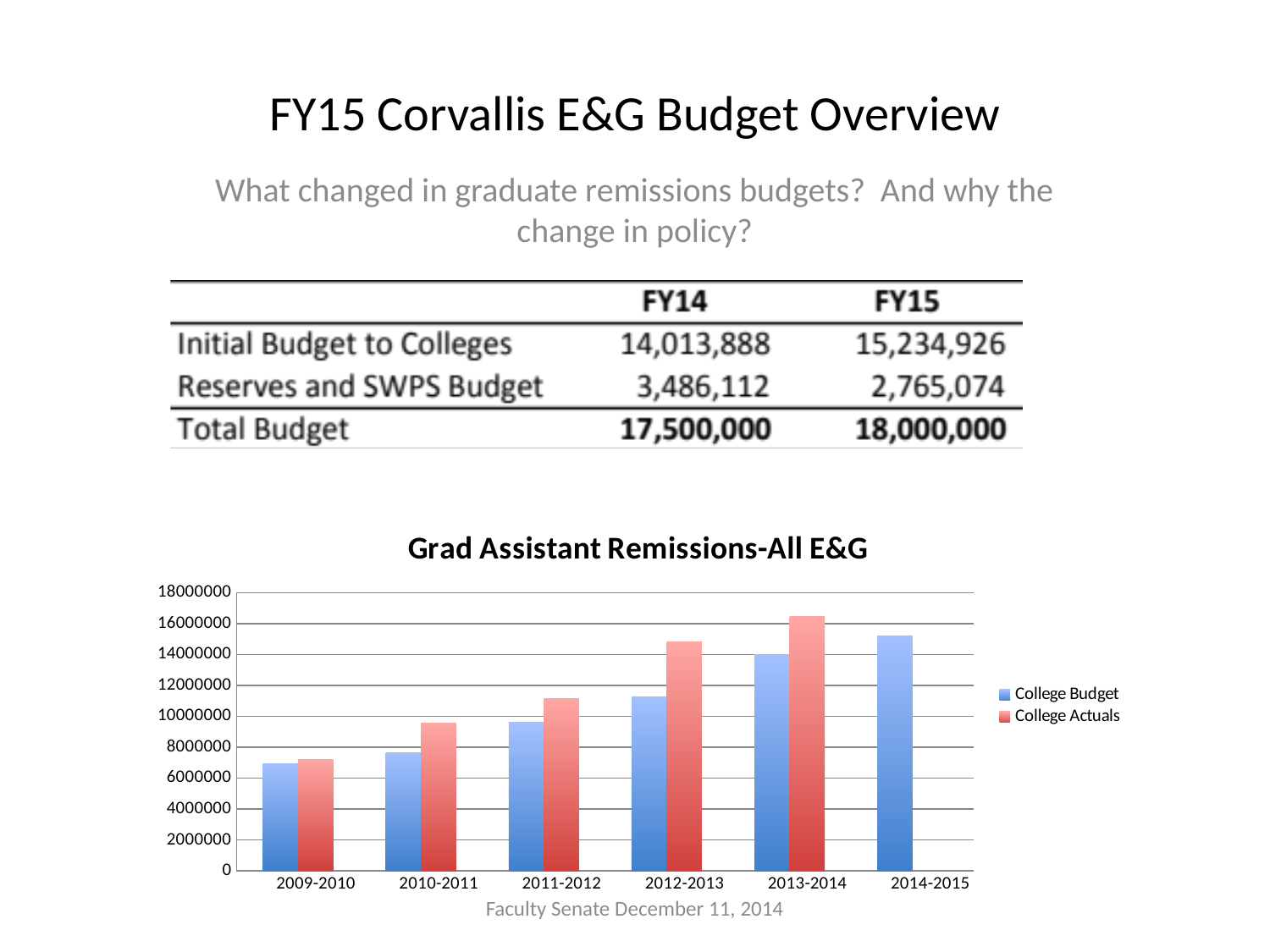
In the Grad Assistant Remissions chart, which year has the highest College Budget value? 2014-2015 Is the College Budget value for 2010-2011 greater or less than 8000000? less Is the College Actuals value for 2013-2014 greater or less than 16000000? greater What kind of chart is shown under the title "Grad Assistant Remissions-All E&G"? bar chart In 2012-2013, which is larger: College Budget or College Actuals? College Actuals In the Grad Assistant Remissions chart, which year has the lowest College Budget value? 2009-2010 Does the College Budget series rise or fall from 2009-2010 to 2014-2015? rise How many series does the legend of the Grad Assistant Remissions chart list? 2 Which series in the Grad Assistant Remissions chart is shown in red? College Actuals How many fiscal-year categories are shown on the x axis of the Grad Assistant Remissions chart? 6 Is the College Actuals value for 2012-2013 greater or less than 14000000? greater In the Grad Assistant Remissions chart, which year has the highest College Actuals value? 2013-2014